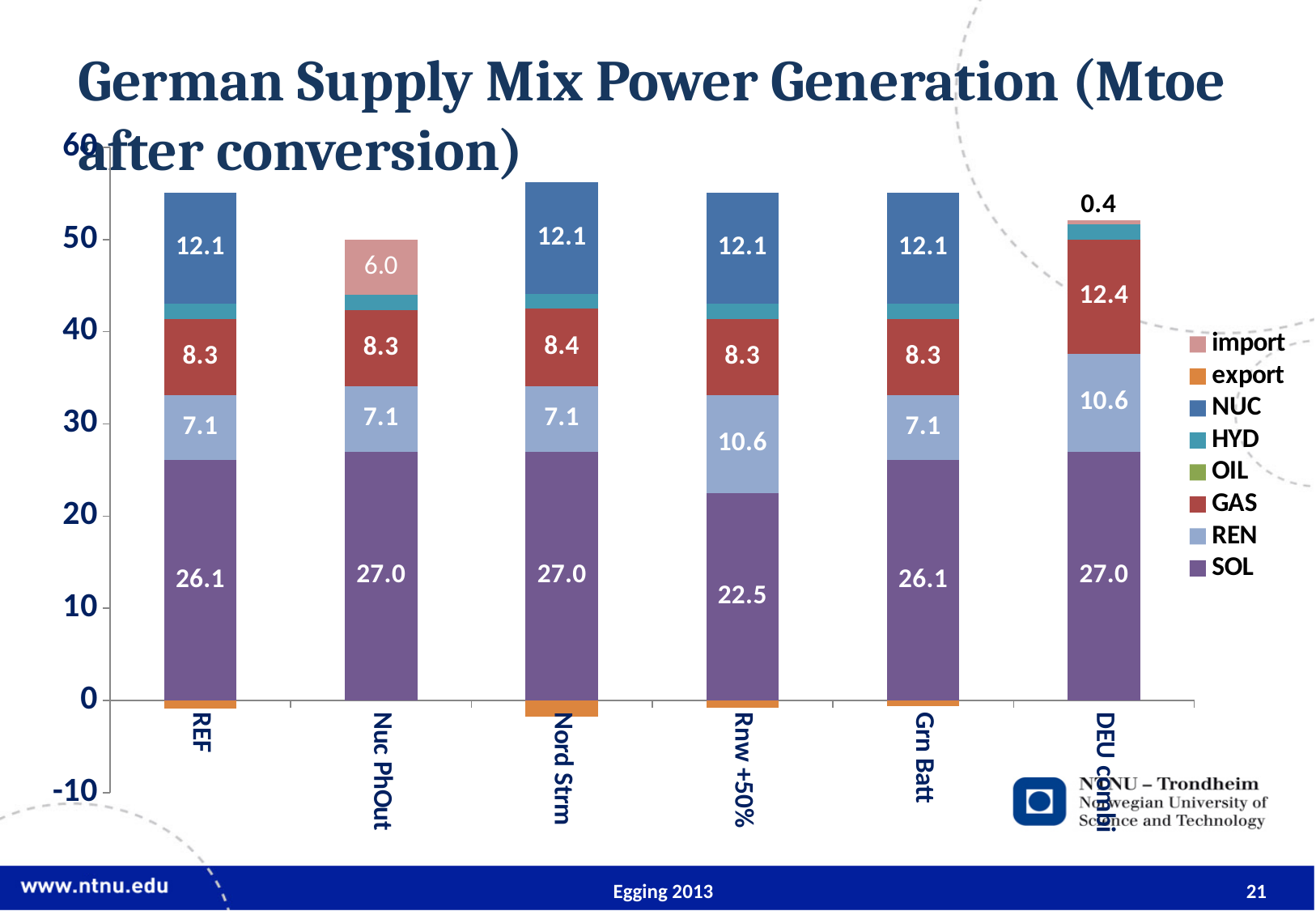
How many scenario categories are shown along the x axis? 6 Is the top of the stacked bar for REF greater or less than 50? greater How many series does the legend list? 8 What is the REN value for the Rnw +50% scenario? 10.6 What kind of chart is shown on the slide? Stacked bar chart Which has the larger REN value, Rnw +50% or REF? Rnw +50% What is the difference between the GAS value for DEU combi and the GAS value for REF? 4.1 Which scenario has the lowest SOL value? Rnw +50% What is the import value for the Nuc PhOut scenario? 6.0 What is the title of the chart? German Supply Mix Power Generation (Mtoe after conversion) What is the SOL value for the Rnw +50% scenario? 22.5 What is the GAS value for the DEU combi scenario? 12.4